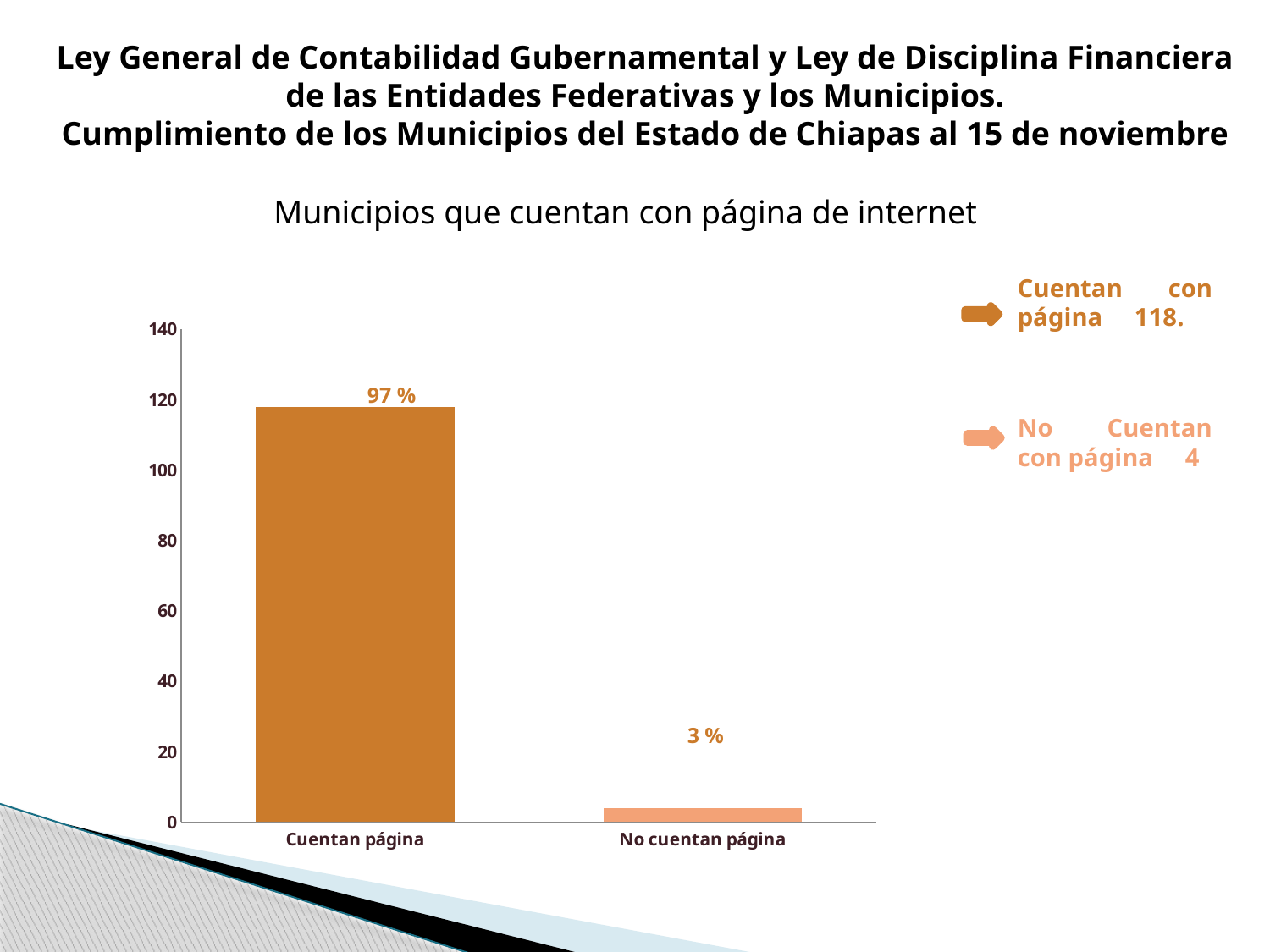
Is the value for Cuentan página greater or less than 100? greater What type of chart is shown on the slide? bar chart How many categories are shown on the x axis of the chart? 2 What data label is shown above the bar for Cuentan página? 97 % Which bar is taller, Cuentan página or No cuentan página? Cuentan página Is the value for No cuentan página greater or less than 20? less What is the title of the chart? Municipios que cuentan con página de internet According to the text beside the chart, how many municipalities have a web page (Cuentan con página)? 118 What data label is shown above the bar for No cuentan página? 3 % Which category has the tallest bar? Cuentan página Which category has the shortest bar? No cuentan página According to the text beside the chart, how many municipalities do not have a web page (No Cuentan con página)? 4